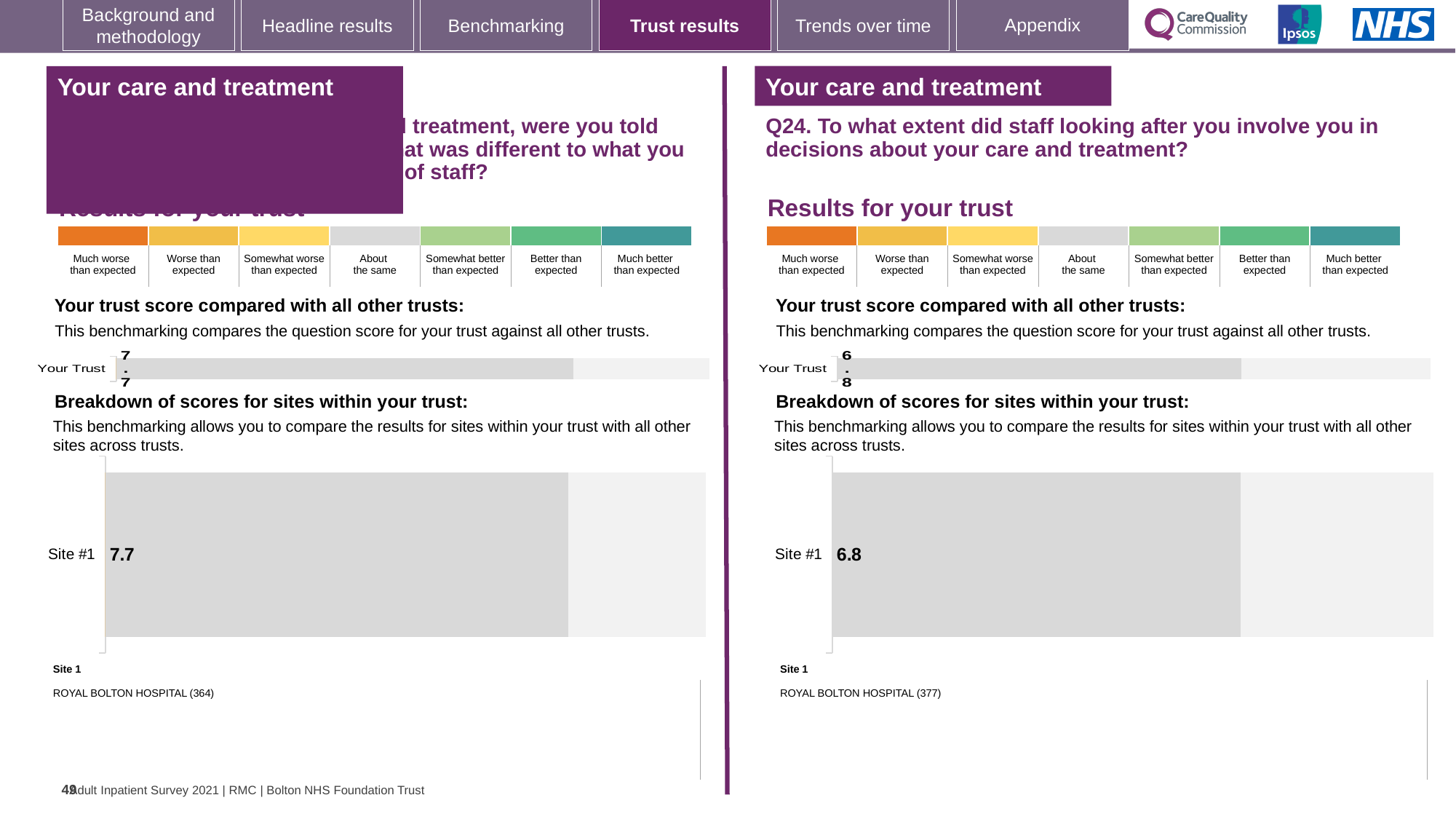
On the left panel's 'Breakdown of scores for sites within your trust' chart, what is the value for Site #1? 7.7 On the right panel's 'Your trust score compared with all other trusts' chart, what is the value for Your Trust? 6.8 Which site is listed as Site 1 below the left panel's site breakdown chart? ROYAL BOLTON HOSPITAL (364) How many sites are shown in the right panel's 'Breakdown of scores for sites within your trust' chart? 1 What type of chart is used to show the Site #1 score on the right panel? Bar chart What is the difference between the Site #1 score on the left panel (7.7) and the Site #1 score on the right panel (6.8)? 0.9 How many sites are shown in the left panel's 'Breakdown of scores for sites within your trust' chart? 1 Which site is listed as Site 1 below the right panel's site breakdown chart? ROYAL BOLTON HOSPITAL (377) Which is larger: the Site #1 score on the left panel or the Site #1 score on the right panel? Left panel (7.7) On the right panel's 'Breakdown of scores for sites within your trust' chart, what is the value for Site #1? 6.8 On the left panel's 'Your trust score compared with all other trusts' chart, what is the value for Your Trust? 7.7 What is the difference between the Your Trust score on the left panel and the Your Trust score on the right panel? 0.9